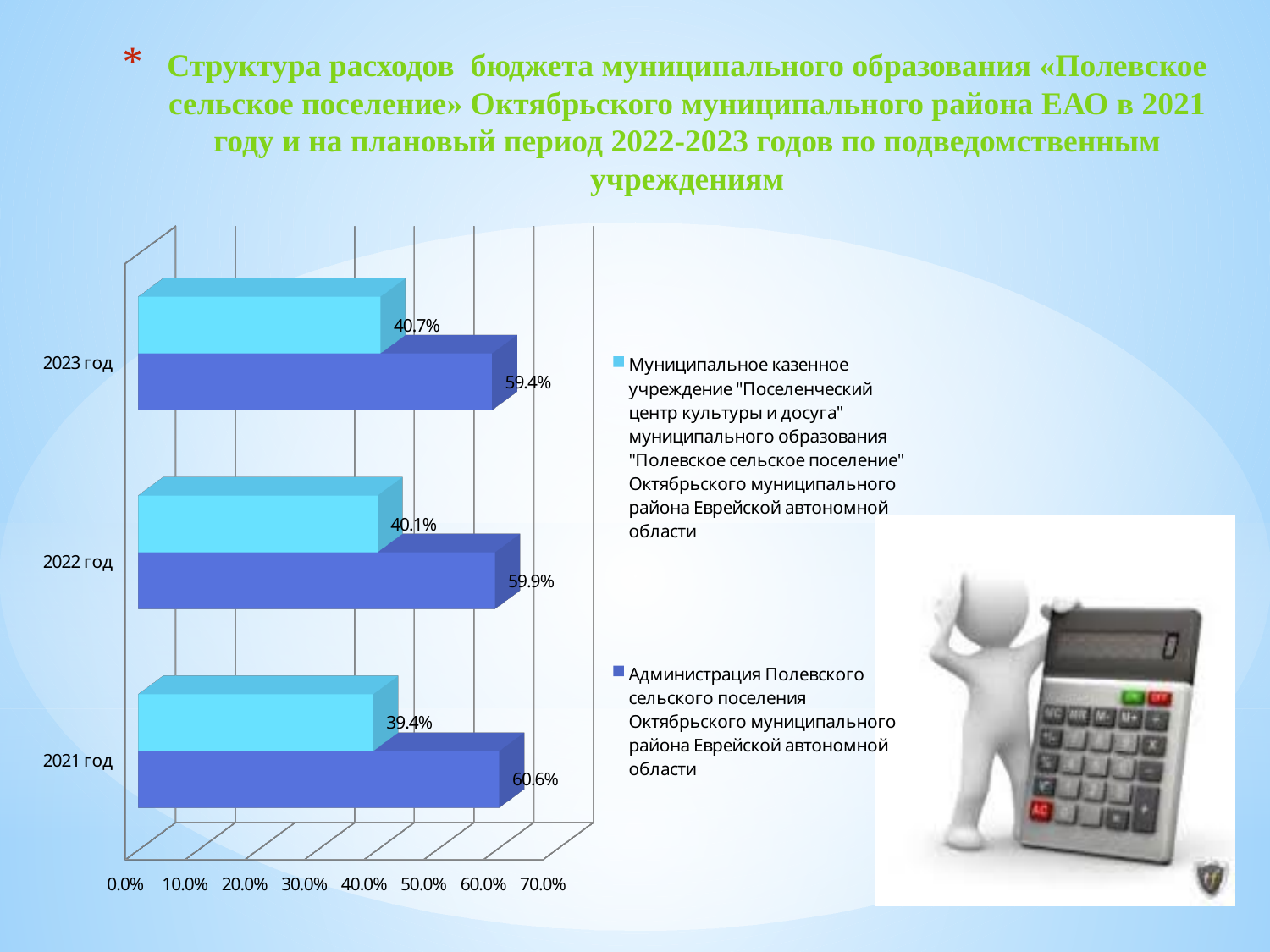
What is the value for the Муниципальное казенное учреждение "Поселенческий центр культуры и досуга" series in 2021 год? 39.4% How many series does the legend list? 2 What is the value for the Муниципальное казенное учреждение "Поселенческий центр культуры и досуга" series in 2023 год? 40.7% What is the value for the Администрация Полевского сельского поселения series in 2021 год? 60.6% What is the difference between the Администрация and the Муниципальное казенное учреждение values in 2022 год? 19.8% In which year is the value for the Администрация Полевского сельского поселения series highest? 2021 год Is the value for the Муниципальное казенное учреждение series in 2022 год greater or less than 50.0%? less In 2023 год, which series has the larger value: Администрация Полевского сельского поселения or Муниципальное казенное учреждение "Поселенческий центр культуры и досуга"? Администрация Полевского сельского поселения How many years (categories) are shown on the chart? 3 In which year is the value for the Муниципальное казенное учреждение "Поселенческий центр культуры и досуга" series lowest? 2021 год What is the value for the Администрация Полевского сельского поселения series in 2022 год? 59.9% What kind of chart is shown on the slide? Bar chart